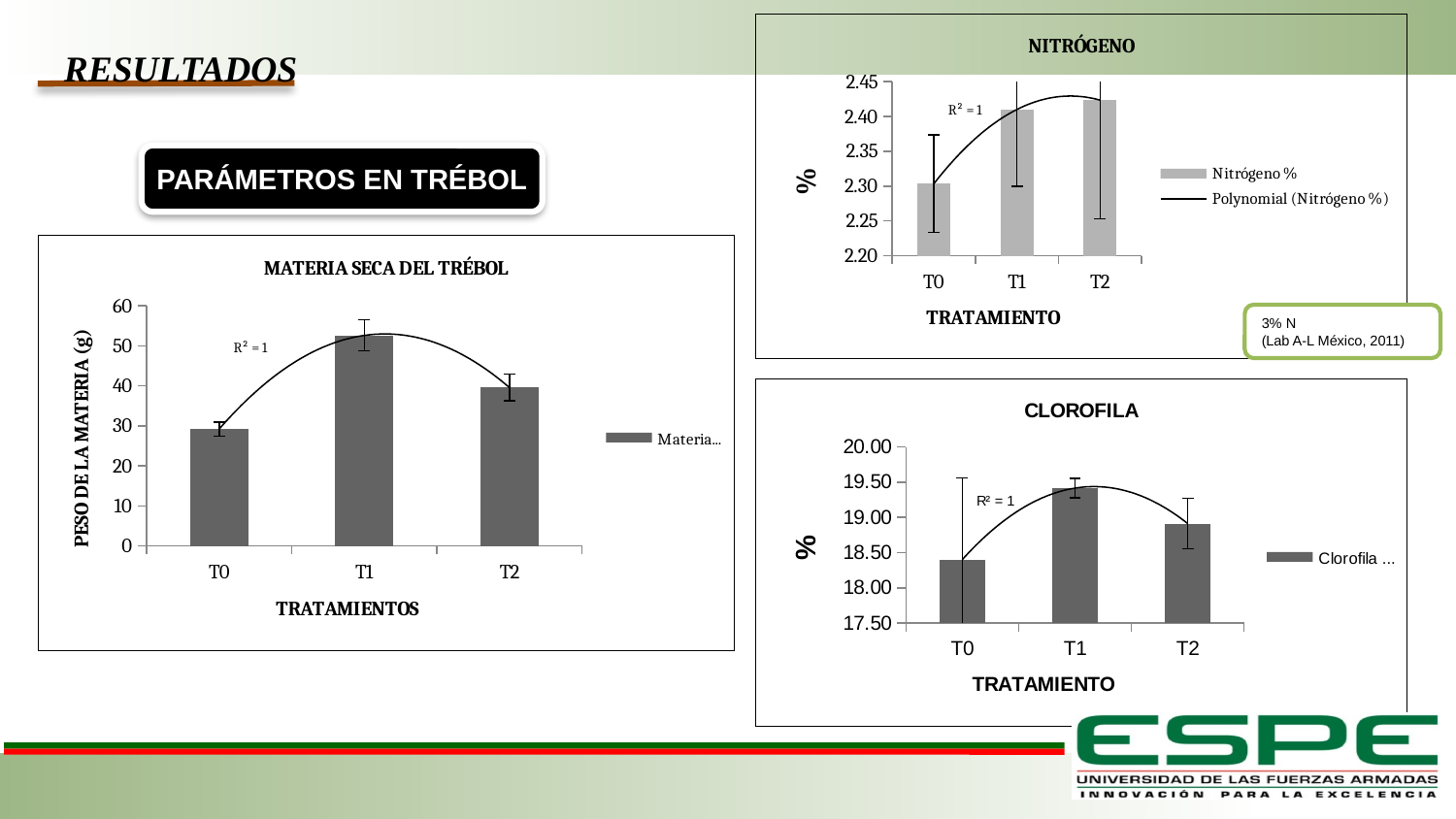
In the CLOROFILA chart, is the value for T1 larger or smaller than the value for T2? larger In the CLOROFILA chart, is the value for T1 greater or less than 19.00? greater In the CLOROFILA chart, which treatment has the highest value? T1 In the MATERIA SECA DEL TRÉBOL chart, which treatment has the lowest value? T0 In the MATERIA SECA DEL TRÉBOL chart, is the value for T1 greater or less than 50? greater In the NITRÓGENO chart, which treatment has the lowest value? T0 In the NITRÓGENO chart, how many entries does the legend list? 2 In the MATERIA SECA DEL TRÉBOL chart, is the value for T2 greater or less than 30? greater In the MATERIA SECA DEL TRÉBOL chart, which treatment has the highest value? T1 In the MATERIA SECA DEL TRÉBOL chart, how many treatments are shown on the x axis? 3 What kind of chart is the CLOROFILA chart? bar chart